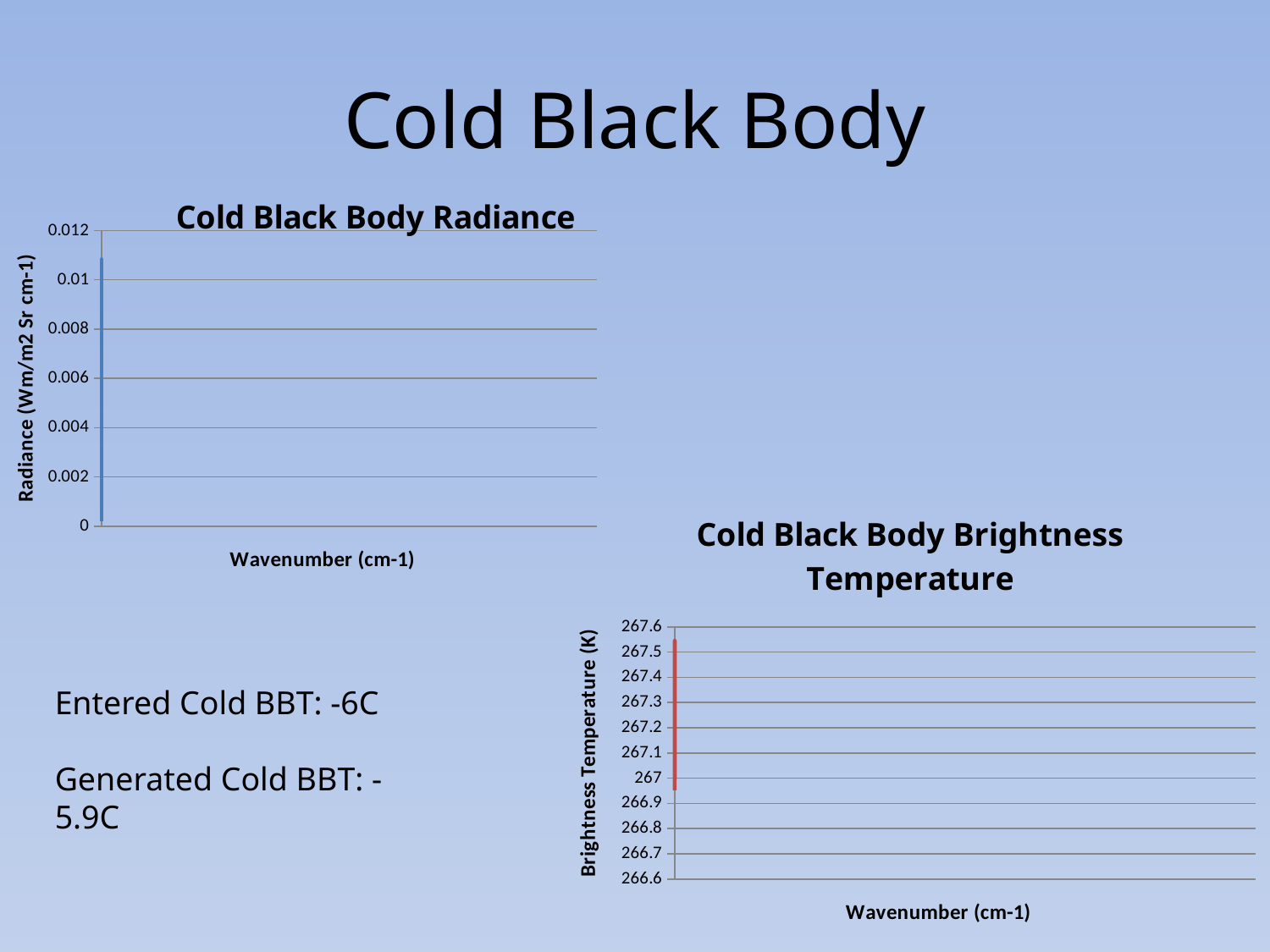
In the "Cold Black Body Radiance" chart, is the highest plotted radiance value greater or less than 0.012? less What type of chart is the "Cold Black Body Brightness Temperature" chart? line chart In the "Cold Black Body Radiance" chart, is the highest plotted radiance value greater or less than 0.006? greater In the "Cold Black Body Brightness Temperature" chart, is the highest plotted brightness temperature greater or less than 267.2? greater What is the x-axis title of the "Cold Black Body Brightness Temperature" chart? Wavenumber (cm-1) What is the y-axis title of the "Cold Black Body Radiance" chart? Radiance (Wm/m2 Sr cm-1) What type of chart is the "Cold Black Body Radiance" chart? line chart